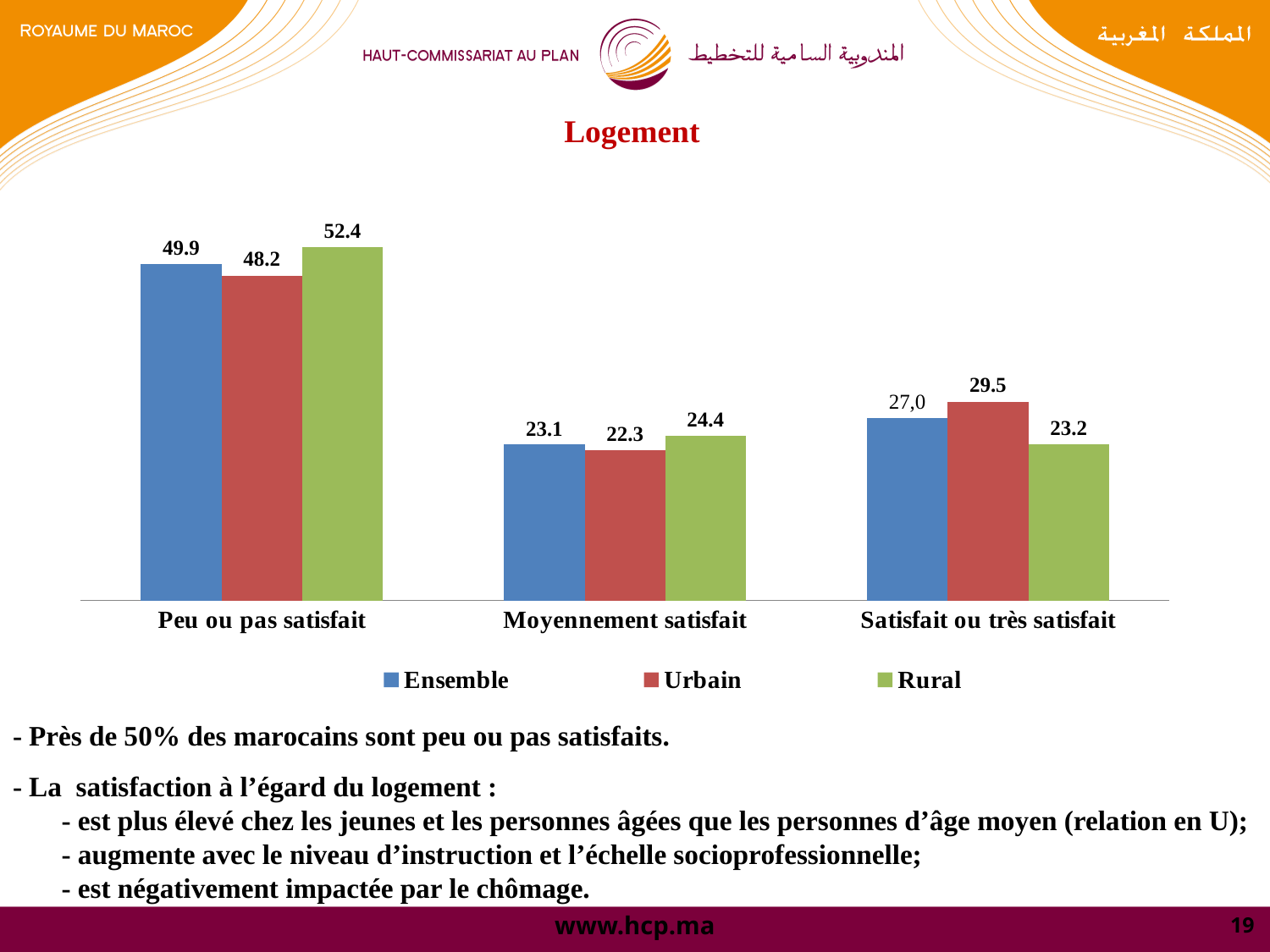
What is the value for Rural in the 'Peu ou pas satisfait' category? 52.4 How many series does the legend list? 3 What kind of chart is shown on the slide? Bar chart Which series has the highest value in the 'Satisfait ou très satisfait' category? Urbain What is the title of the chart? Logement Which series has the lowest value in the 'Peu ou pas satisfait' category? Urbain What is the value for Ensemble in the 'Satisfait ou très satisfait' category? 27,0 Which is larger: the Ensemble value for 'Moyennement satisfait' or the Ensemble value for 'Satisfait ou très satisfait'? Satisfait ou très satisfait What is the difference between the Rural and Ensemble values in the 'Peu ou pas satisfait' category? 2.5 What is the difference between the Urbain and Rural values in the 'Satisfait ou très satisfait' category? 6.3 What is the value for Urbain in the 'Moyennement satisfait' category? 22.3 How many categories are shown on the x axis? 3